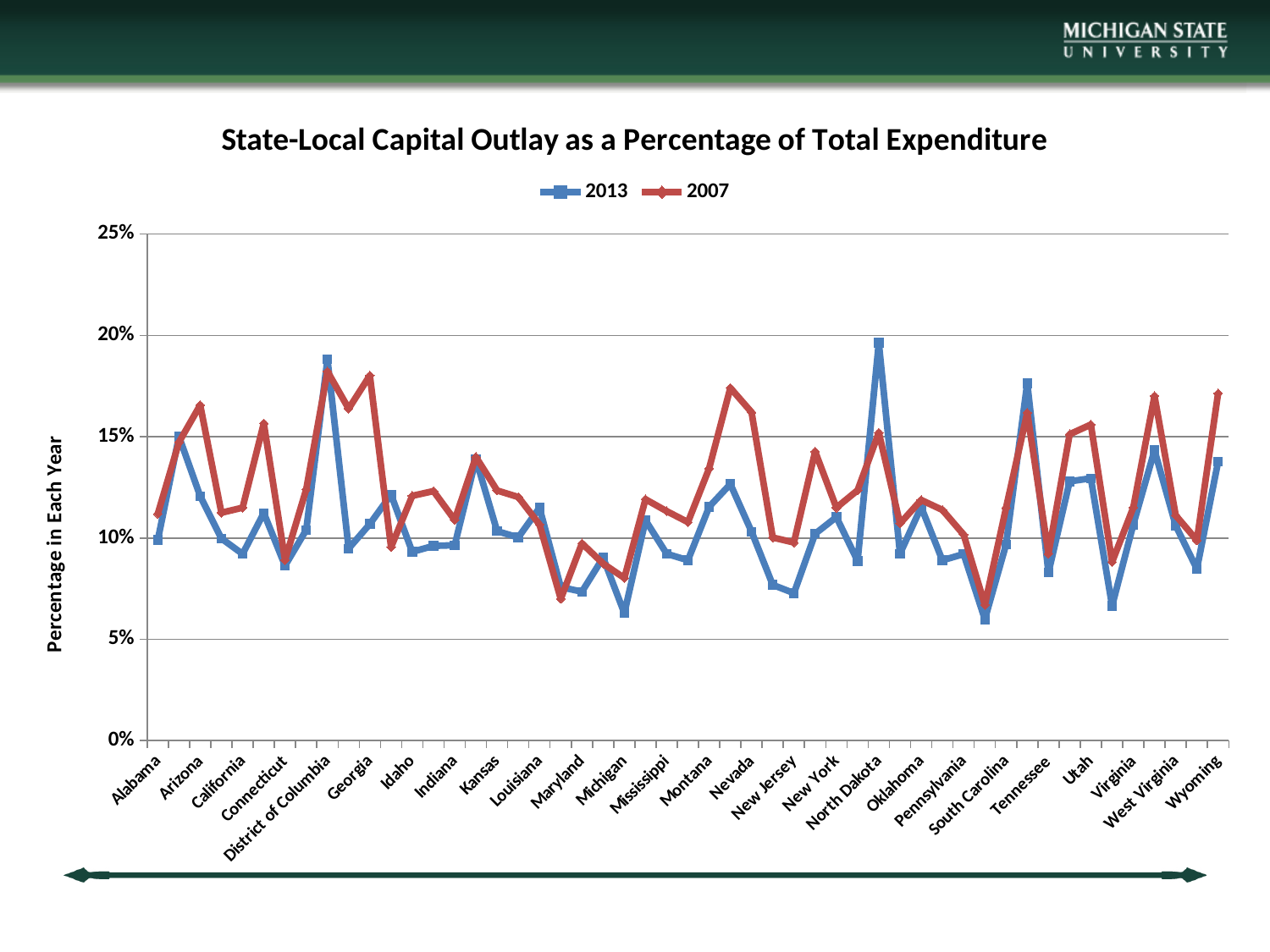
For Georgia, which series has the larger value, 2013 or 2007? 2007 Is the 2013 value for North Dakota greater or less than 15%? greater How many series does the legend list? 2 Is the 2013 value for Michigan greater or less than 10%? less For North Dakota, which series has the larger value, 2013 or 2007? 2013 Is the 2007 value for Nevada greater or less than 15%? greater What is the title of the chart? State-Local Capital Outlay as a Percentage of Total Expenditure Which labeled state has the highest 2013 value? North Dakota What kind of chart is shown on the slide? line chart Which series is drawn in red? 2007